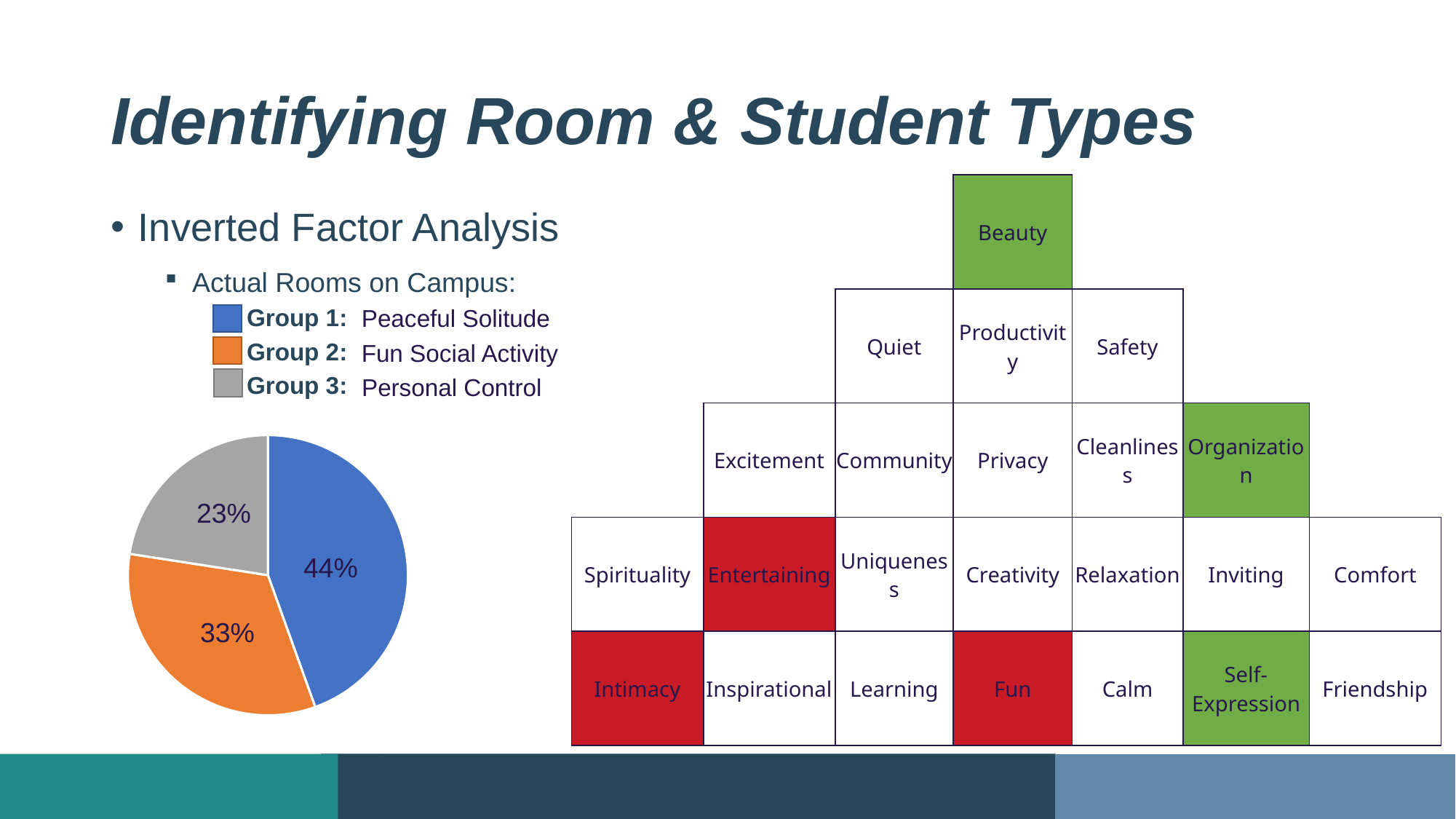
What is the difference in percentage points between the Group 2 slice and the Group 3 slice? 10 What kind of chart is shown on the left of the slide? pie chart What share of the pie does the orange slice (Group 2: Fun Social Activity) represent? 33% Which is larger in the pie chart, the Group 2 slice or the Group 3 slice? Group 2 Which group has the largest slice of the pie chart? Group 1: Peaceful Solitude Which colour represents Group 2 (Fun Social Activity) in the pie chart? orange What is the difference in percentage points between the Group 1 slice and the Group 3 slice? 21 How many slices does the pie chart have? 3 What share of the pie does the gray slice (Group 3: Personal Control) represent? 23% What label is given to Group 3 in the pie chart's key? Personal Control Which group has the smallest slice of the pie chart? Group 3: Personal Control What share of the pie does the blue slice (Group 1: Peaceful Solitude) represent? 44%